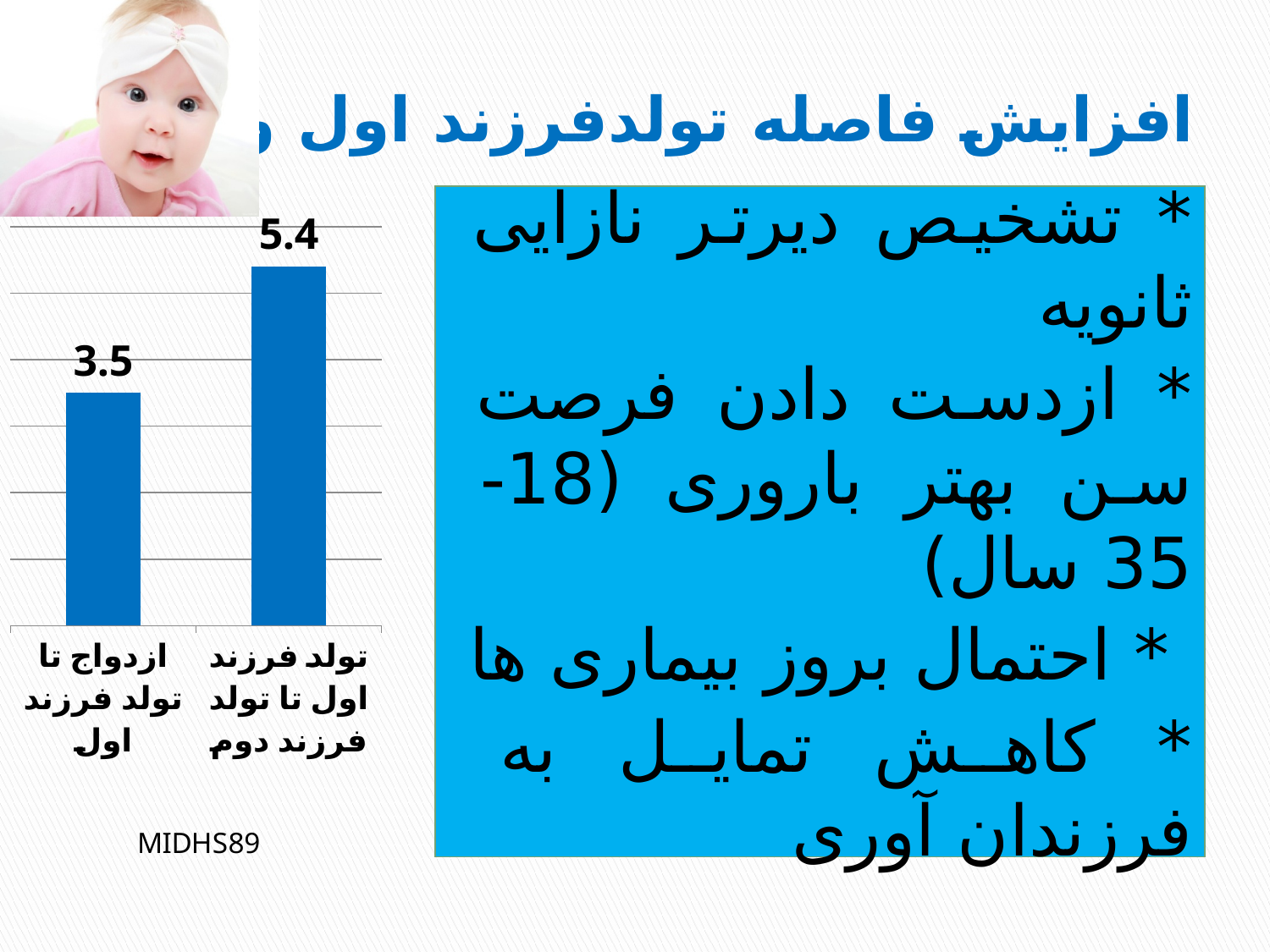
Which is larger: the value for "ازدواج تا تولد فرزند اول" or the value for "تولد فرزند اول تا تولد فرزند دوم"? تولد فرزند اول تا تولد فرزند دوم What is the value for the bar labelled "ازدواج تا تولد فرزند اول"? 3.5 What is the value for the bar labelled "تولد فرزند اول تا تولد فرزند دوم"? 5.4 How many bars are shown in the chart? 2 Which category has the highest value in the chart? تولد فرزند اول تا تولد فرزند دوم What source label is printed below the chart? MIDHS89 What kind of chart is shown on the slide? bar chart Which category has the lowest value in the chart? ازدواج تا تولد فرزند اول What colour are the bars in the chart? blue What is the difference between the values for "تولد فرزند اول تا تولد فرزند دوم" and "ازدواج تا تولد فرزند اول"? 1.9